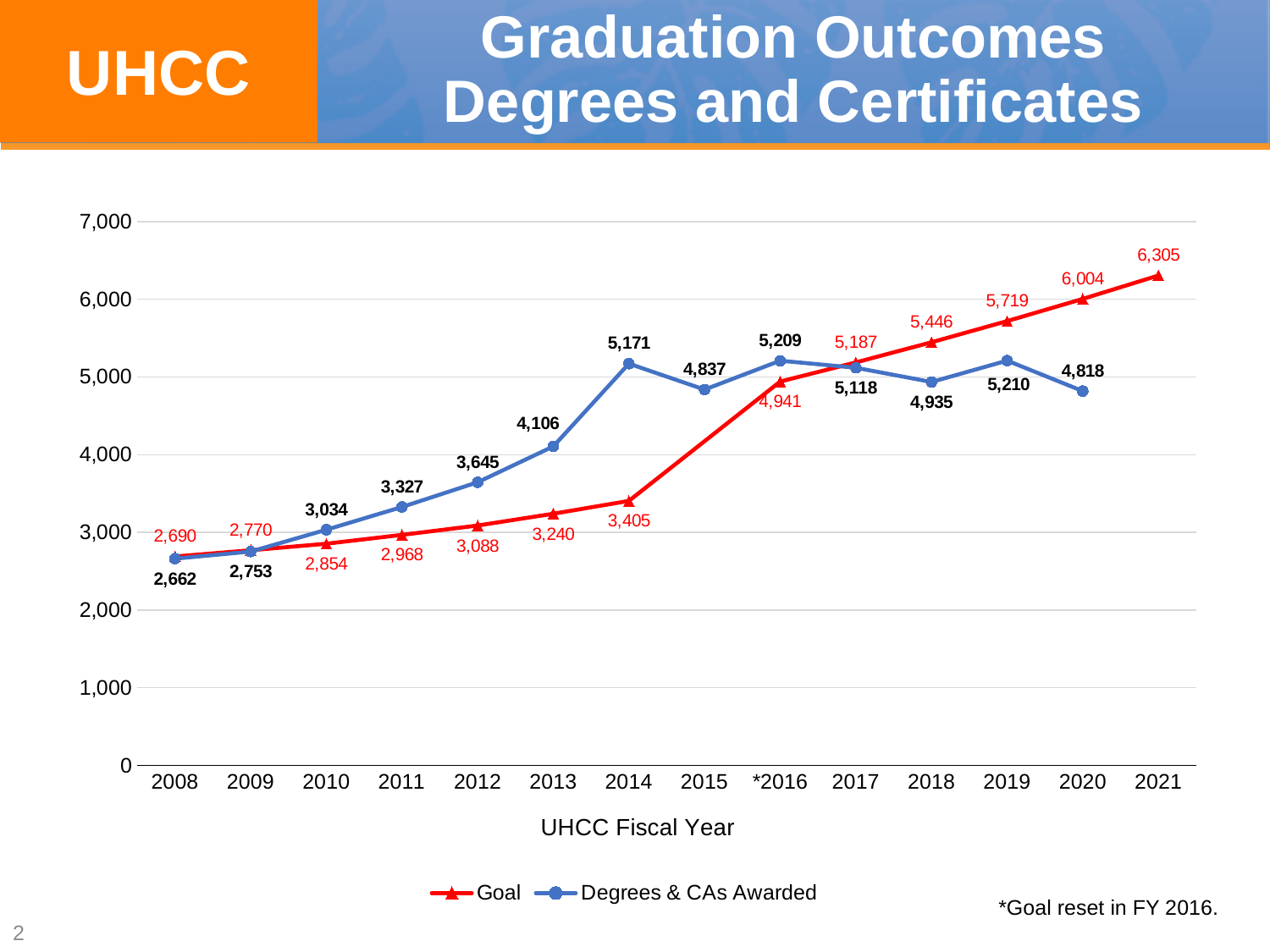
What is the difference between the Goal and Degrees & CAs Awarded in 2020? 1,186 How many series does the legend list? 2 In which fiscal year is Degrees & CAs Awarded at its lowest? 2008 By how much did Degrees & CAs Awarded exceed the Goal in 2013? 866 What is the value of Degrees & CAs Awarded in 2018? 4,935 Is the value of Degrees & CAs Awarded in 2015 greater or less than 5,000? less What kind of chart is shown on the slide? line chart What is the value of Degrees & CAs Awarded in 2014? 5,171 How many fiscal years are shown on the x axis? 14 In 2014, which is larger: the Goal or Degrees & CAs Awarded? Degrees & CAs Awarded In which fiscal year is the Goal series at its highest? 2021 What is the Goal value for 2021? 6,305